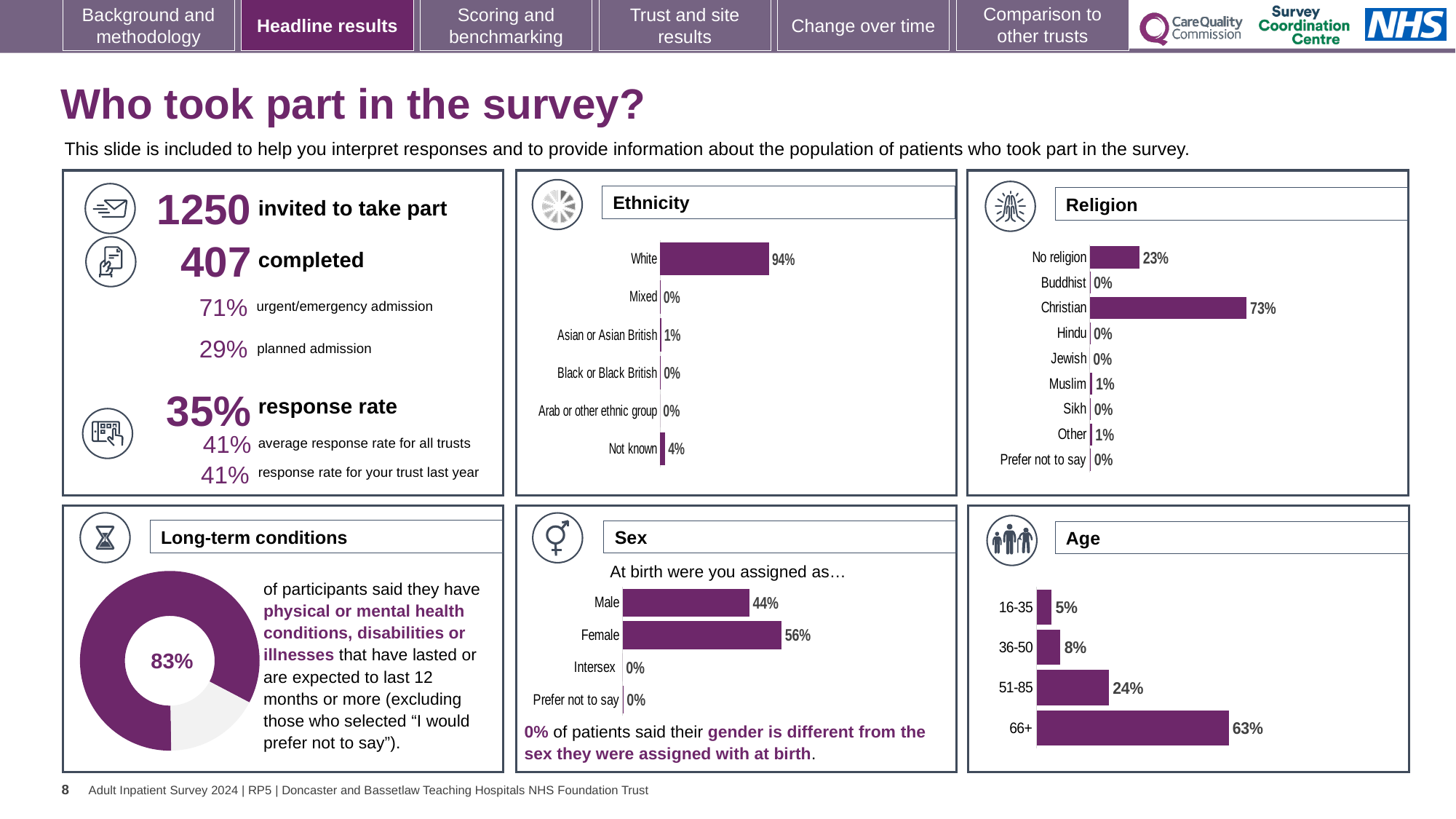
In the Religion chart, what is the difference between the Christian and No religion values? 50 percentage points In the Religion chart, what percentage of respondents were Christian? 73% In the Ethnicity chart, which category has the highest value? White In the Sex chart, which is larger, Male or Female? Female In the Sex chart, what percentage of respondents were assigned Female at birth? 56% In the Age chart, which age group has the lowest value? 16-35 In the Ethnicity chart, how many categories are shown? 6 What kind of chart is used in the Long-term conditions panel? doughnut chart In the Ethnicity chart, what percentage of respondents were White? 94% In the Age chart, do the values rise or fall as the age groups get older? rise In the Age chart, what percentage of respondents were aged 66+? 63% In the Religion chart, how many categories are shown? 9